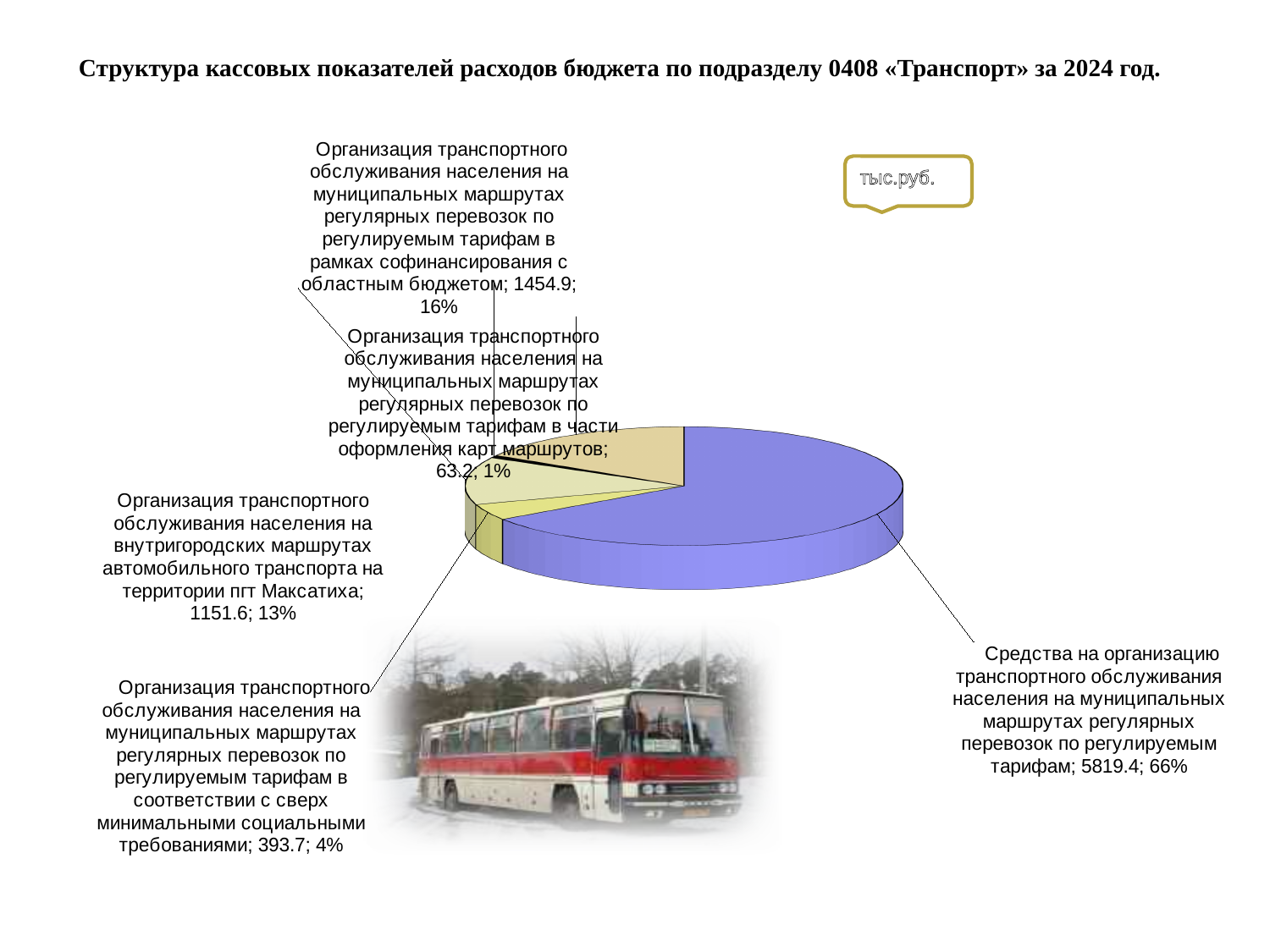
How many slices does the pie chart have? 5 What kind of chart is shown on the slide? pie chart What is the difference between the value for 'в рамках софинансирования с областным бюджетом' (1454.9) and the value for 'на территории пгт Максатиха' (1151.6)? 303.3 What share of the pie does the slice for transport services 'в рамках софинансирования с областным бюджетом' represent? 16% What share of the pie does the slice for transport services 'в соответствии с сверх минимальными социальными требованиями' represent? 4% In what units are the values on the chart given, according to the callout on the slide? тыс.руб. What year does the chart title refer to? 2024 What is the value for 'Организация транспортного обслуживания населения на внутригородских маршрутах автомобильного транспорта на территории пгт Максатиха'? 1151.6 Which is larger: the value for 'в соответствии с сверх минимальными социальными требованиями' or the value for 'в части оформления карт маршрутов'? в соответствии с сверх минимальными социальными требованиями Which category has the smallest slice of the pie chart? Организация транспортного обслуживания населения на муниципальных маршрутах регулярных перевозок по регулируемым тарифам в части оформления карт маршрутов Which category has the largest slice of the pie chart? Средства на организацию транспортного обслуживания населения на муниципальных маршрутах регулярных перевозок по регулируемым тарифам What is the value for 'Средства на организацию транспортного обслуживания населения на муниципальных маршрутах регулярных перевозок по регулируемым тарифам'? 5819.4